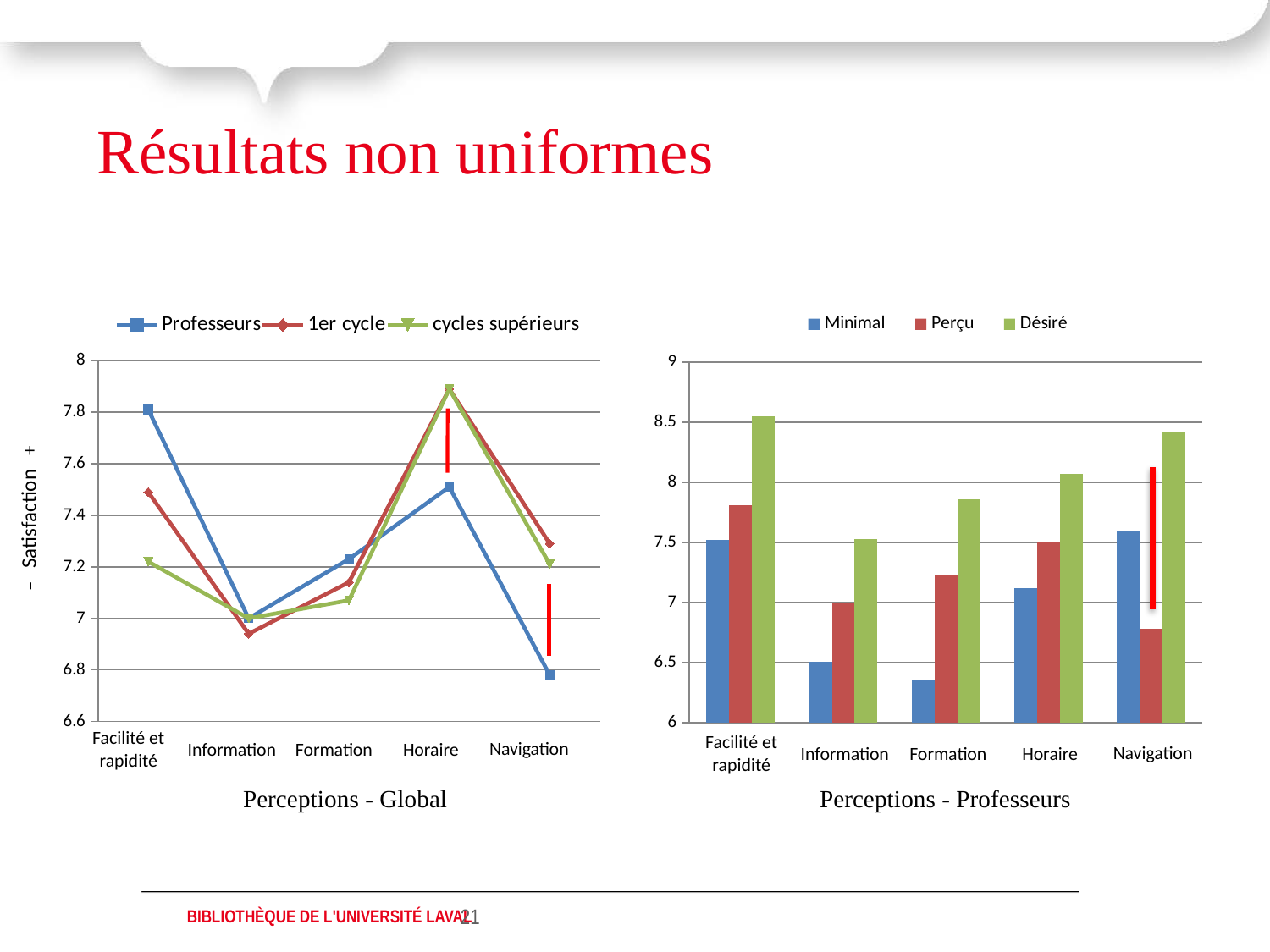
What kind of chart is the 'Perceptions - Global' chart on the left? line chart What are the three legend entries of the 'Perceptions - Professeurs' chart? Minimal, Perçu, Désiré In the 'Perceptions - Global' chart, does the Professeurs line rise or fall from Horaire to Navigation? fall In the 'Perceptions - Professeurs' chart, how many categories are shown on the x axis? 5 In the 'Perceptions - Professeurs' chart, which category has the highest Désiré bar? Facilité et rapidité In the 'Perceptions - Global' chart, how many series does the legend list? 3 In the 'Perceptions - Professeurs' chart, which category has the lowest Minimal bar? Formation In the 'Perceptions - Professeurs' chart, for Navigation, which is larger: Minimal or Perçu? Minimal In the 'Perceptions - Global' chart, which category has the lowest Professeurs value? Navigation What kind of chart is the 'Perceptions - Professeurs' chart on the right? bar chart In the 'Perceptions - Professeurs' chart, is the Minimal value for Information greater or less than 7? less In the 'Perceptions - Global' chart, is the Professeurs value for Facilité et rapidité greater or less than 7.6? greater